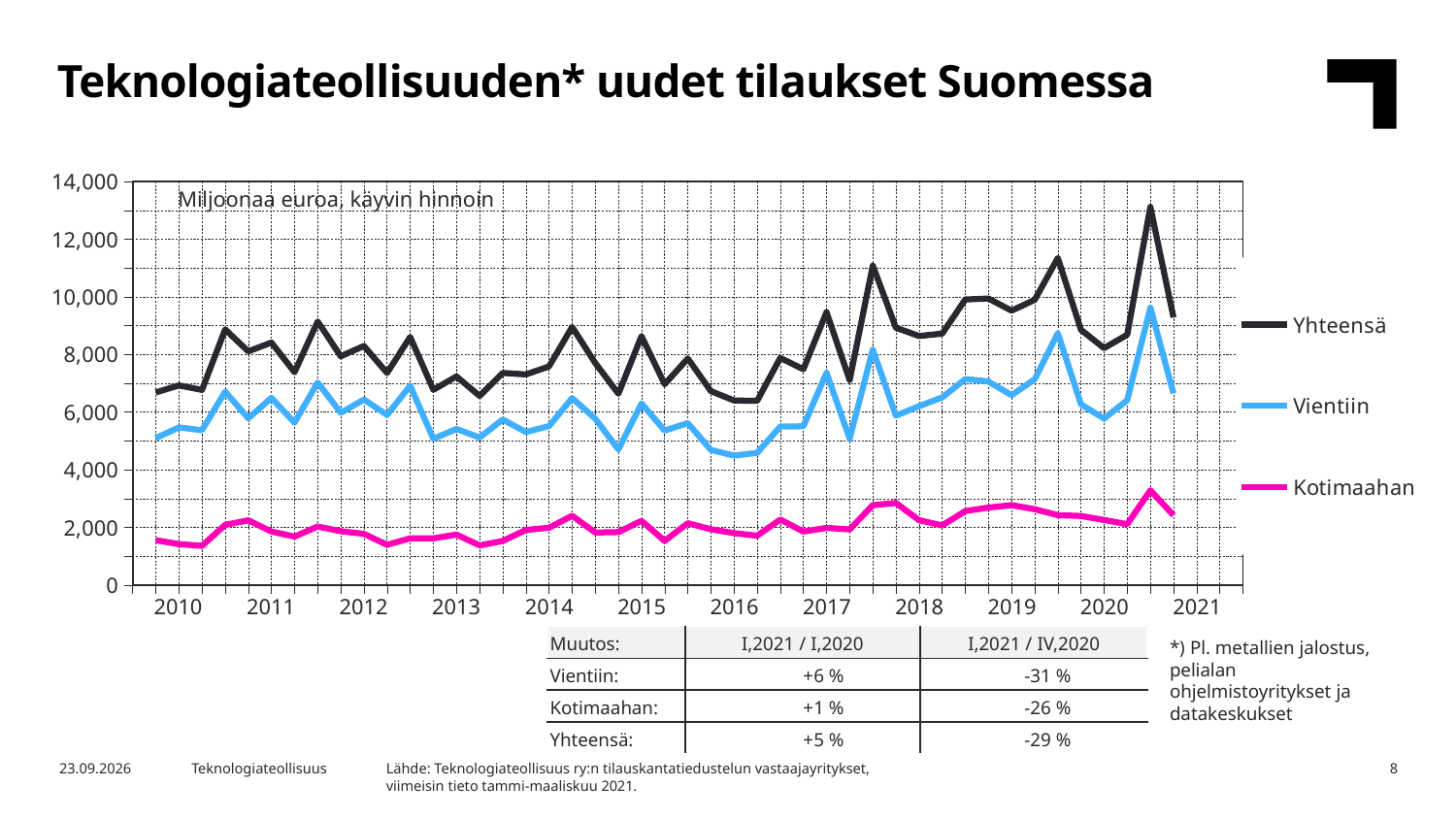
What unit is stated in the chart's annotation? Miljoonaa euroa, käyvin hinnoin Is the highest value of the Kotimaahan line greater or less than 4,000? less Which is larger at the 2020 peak: Vientiin or Kotimaahan? Vientiin Which series has the highest values throughout the chart? Yhteensä Is the highest peak of the Yhteensä line (in 2020) greater or less than 12,000? greater Which series has the lowest values throughout the chart? Kotimaahan Is the peak of the Vientiin line in 2020 greater or less than 8,000? greater How many series does the legend list? 3 What kind of chart is shown on the slide? line chart How many year labels are shown on the x axis? 12 Which series is plotted with the black line? Yhteensä